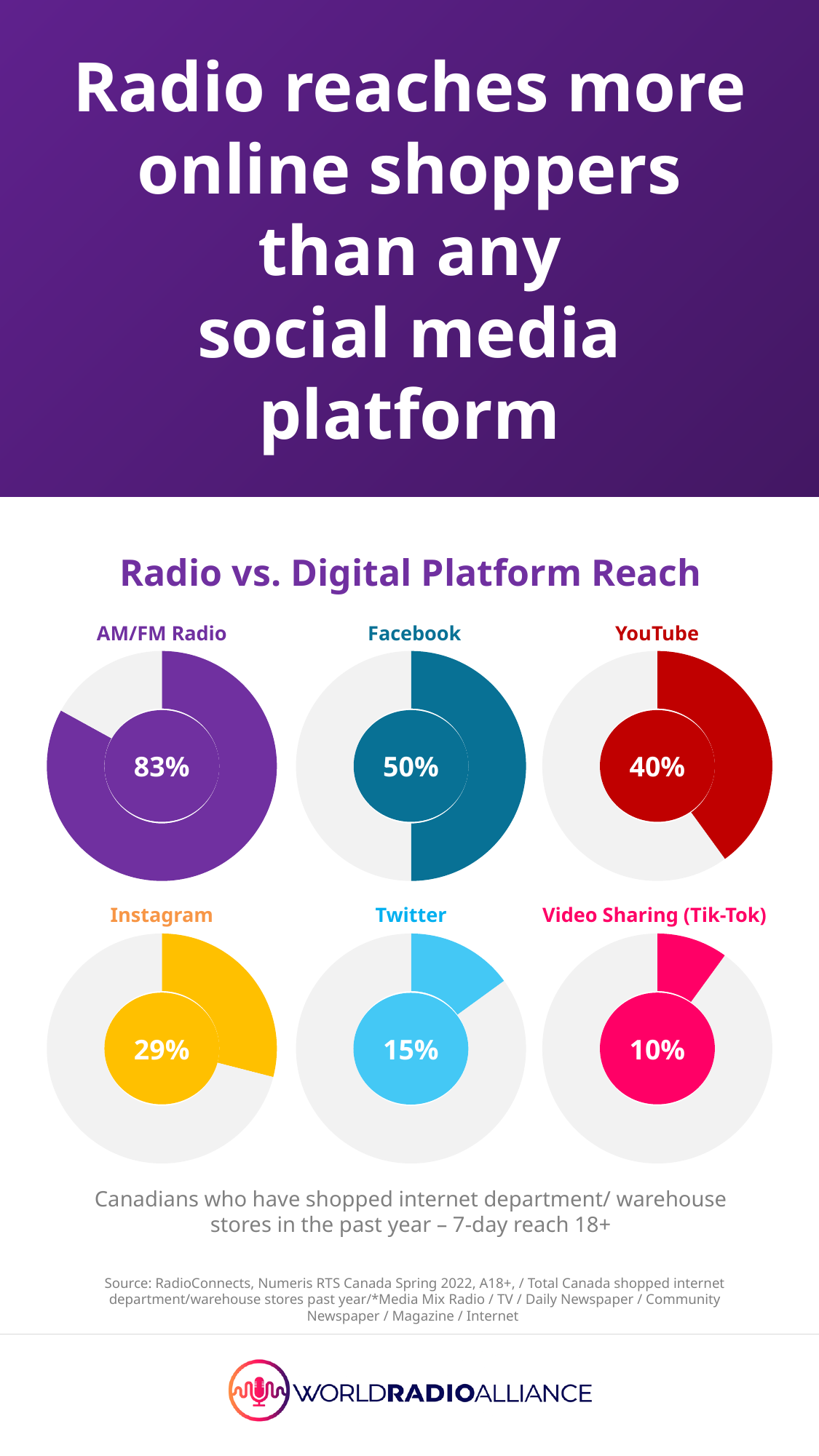
In the Radio vs. Digital Platform Reach chart, which platform has the highest reach? AM/FM Radio In the Radio vs. Digital Platform Reach chart, what is the difference between the reach of Instagram and Twitter? 14% In the Radio vs. Digital Platform Reach chart, which platform has the lowest reach? Video Sharing (Tik-Tok) In the Radio vs. Digital Platform Reach chart, what is the reach value for AM/FM Radio? 83% In the Radio vs. Digital Platform Reach chart, which has a larger reach, YouTube or Instagram? YouTube How many platforms are shown in the Radio vs. Digital Platform Reach chart? 6 In the Radio vs. Digital Platform Reach chart, what is the reach value for Video Sharing (Tik-Tok)? 10% What kind of chart is used to show each platform's reach in the Radio vs. Digital Platform Reach chart? Donut chart In the Radio vs. Digital Platform Reach chart, what is the reach value for YouTube? 40% In the Radio vs. Digital Platform Reach chart, what is the reach value for Facebook? 50% In the Radio vs. Digital Platform Reach chart, what is the difference between the reach of AM/FM Radio and Facebook? 33% In the Radio vs. Digital Platform Reach chart, what is the reach value for Instagram? 29%